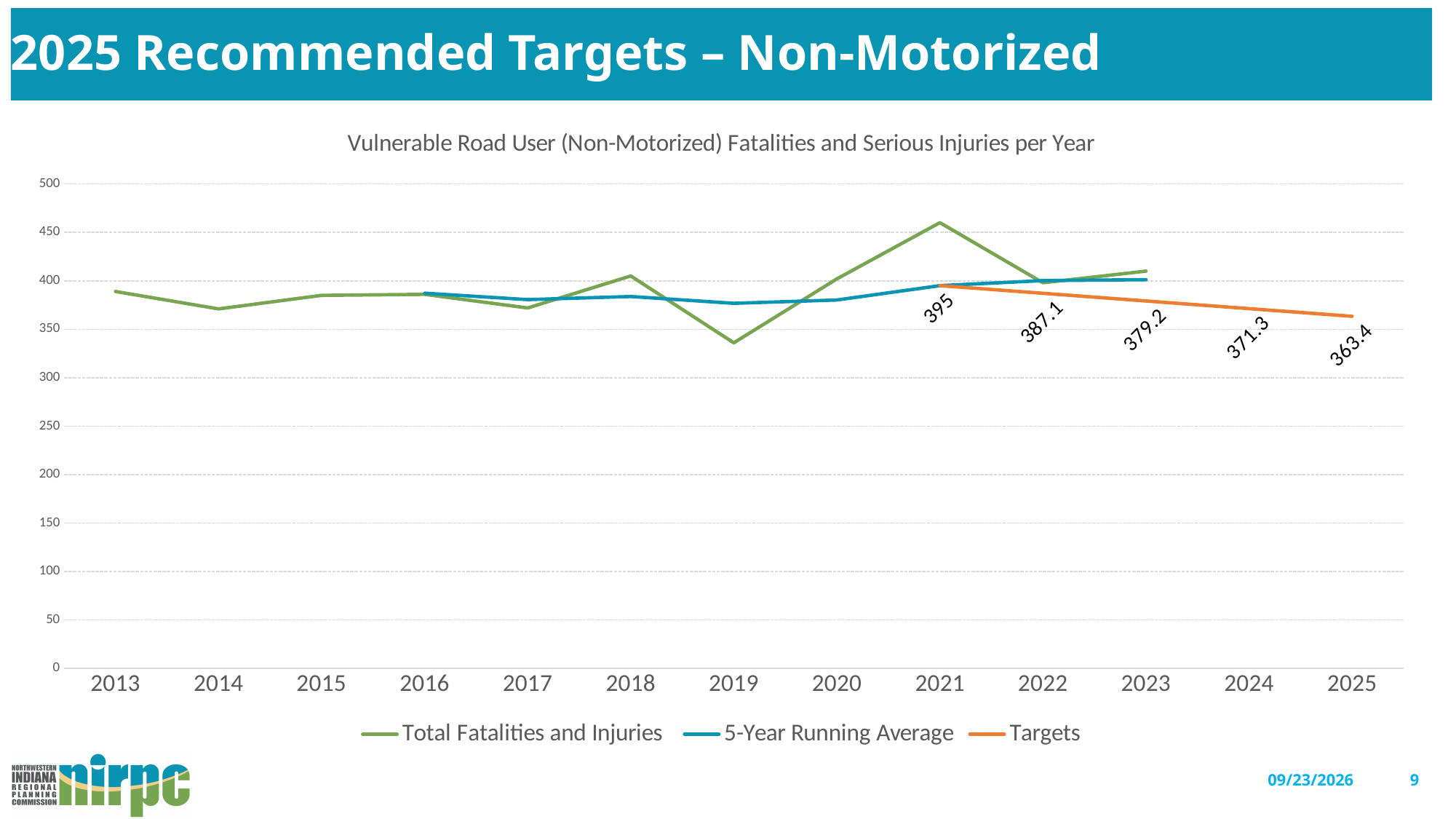
What is the difference between the Targets values for 2022 and 2024? 15.8 How many series does the legend list? 3 What is the Targets value for 2023? 379.2 In which year is the Total Fatalities and Injuries line at its lowest? 2019 What is the Targets value for 2021? 395 Is the Total Fatalities and Injuries value for 2021 greater or less than 450? greater Do the Targets values rise or fall from 2021 to 2025? fall What kind of chart is shown on the slide? line chart What is the Targets value for 2025? 363.4 In which year is the Total Fatalities and Injuries line at its highest? 2021 What is the difference between the Targets values for 2021 and 2025? 31.6 Is the Total Fatalities and Injuries value for 2019 greater or less than 350? less